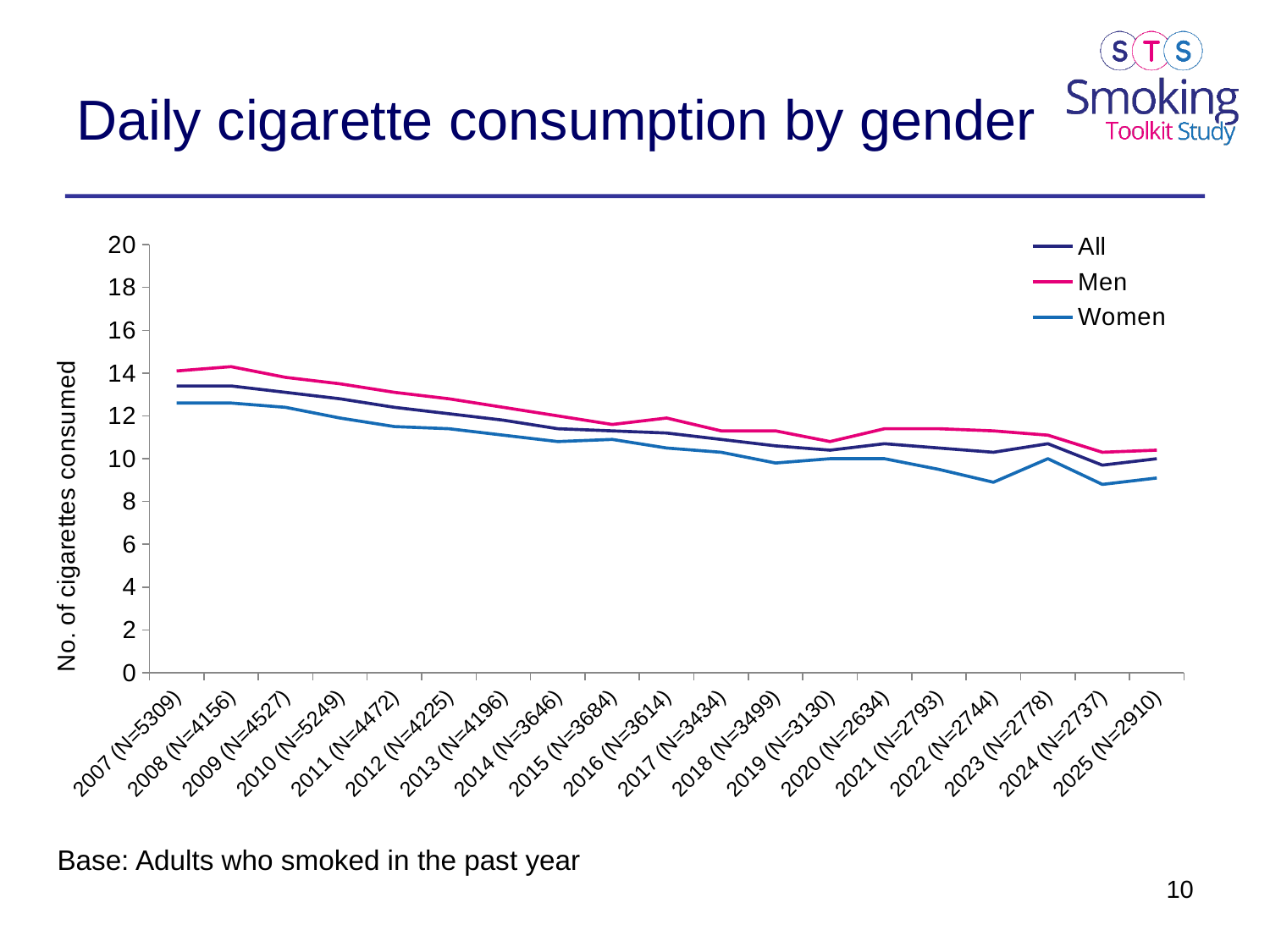
Is the value for Men in 2008 (N=4156) greater or less than 14? greater In 2007 (N=5309), which is larger, the value for Men or the value for Women? Men How many series does the legend list? 3 Which series has the highest values across the years: All, Men or Women? Men Which series has the lowest values across the years: All, Men or Women? Women What kind of chart is shown on the slide? Line chart What is the label of the y axis? No. of cigarettes consumed How many years are plotted along the x axis? 19 What is the title of the chart? Daily cigarette consumption by gender Do the values for Men rise or fall overall from 2007 to 2025? Fall Is the value for Women in 2007 (N=5309) greater or less than 12? greater Is the value for Women in 2022 (N=2744) greater or less than 10? less